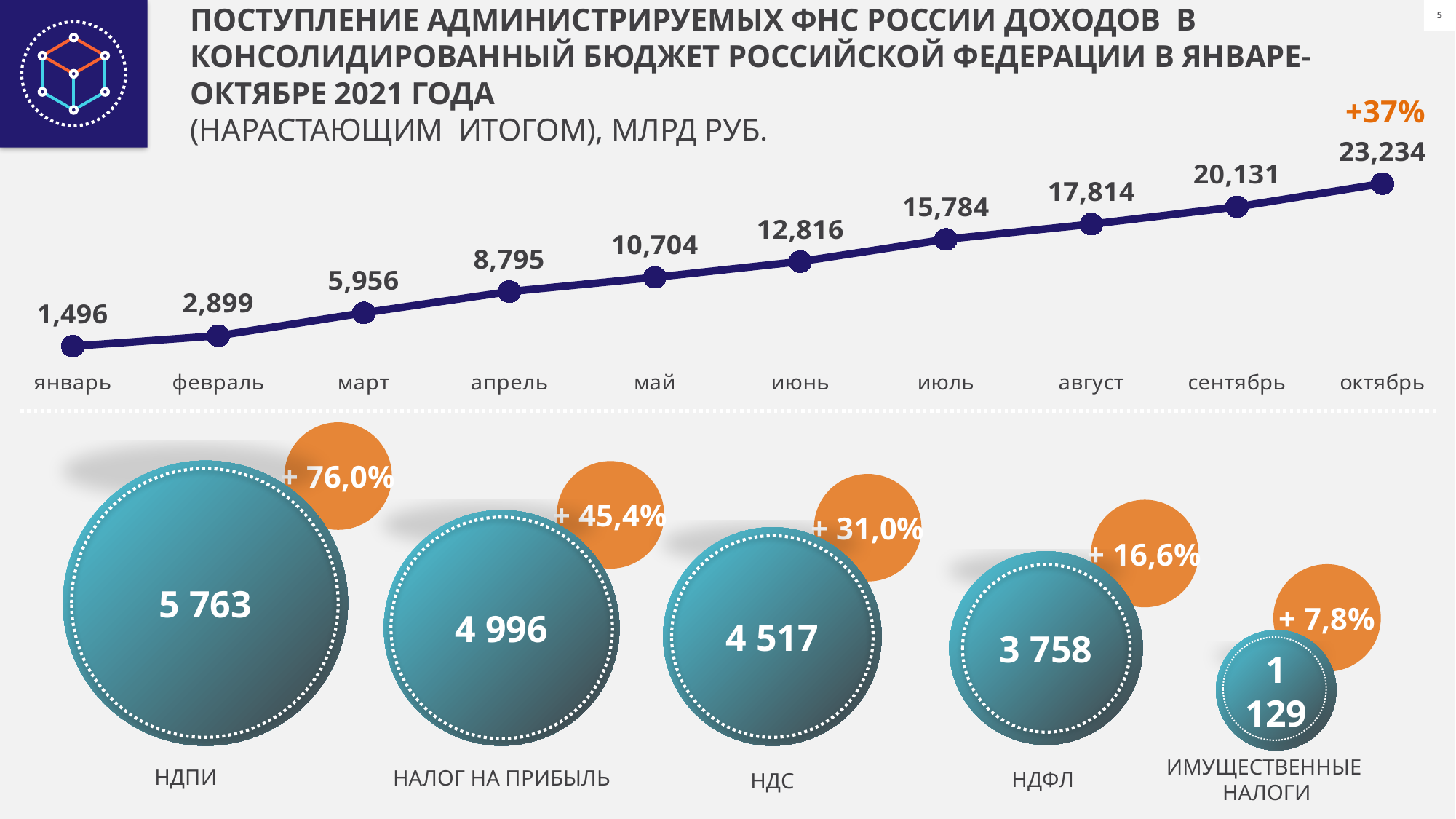
On the line chart, what is the difference between the values for октябрь and сентябрь? 3,103 On the line chart, which is larger: the value for май or the value for апрель? май On the line chart, what is the value for июль? 15,784 On the line chart, which month has the lowest value? январь In the bubble chart at the bottom, what is the value shown for НДС? 4 517 On the line chart, what is the value for март? 5,956 On the line chart, do the values rise or fall from январь to октябрь? rise On the line chart, which month has the highest value? октябрь In the bubble chart at the bottom, what percentage growth is shown for НДПИ? + 76,0% What kind of chart is shown in the upper part of the slide? line chart On the line chart, what is the value for октябрь? 23,234 How many months are plotted on the line chart? 10